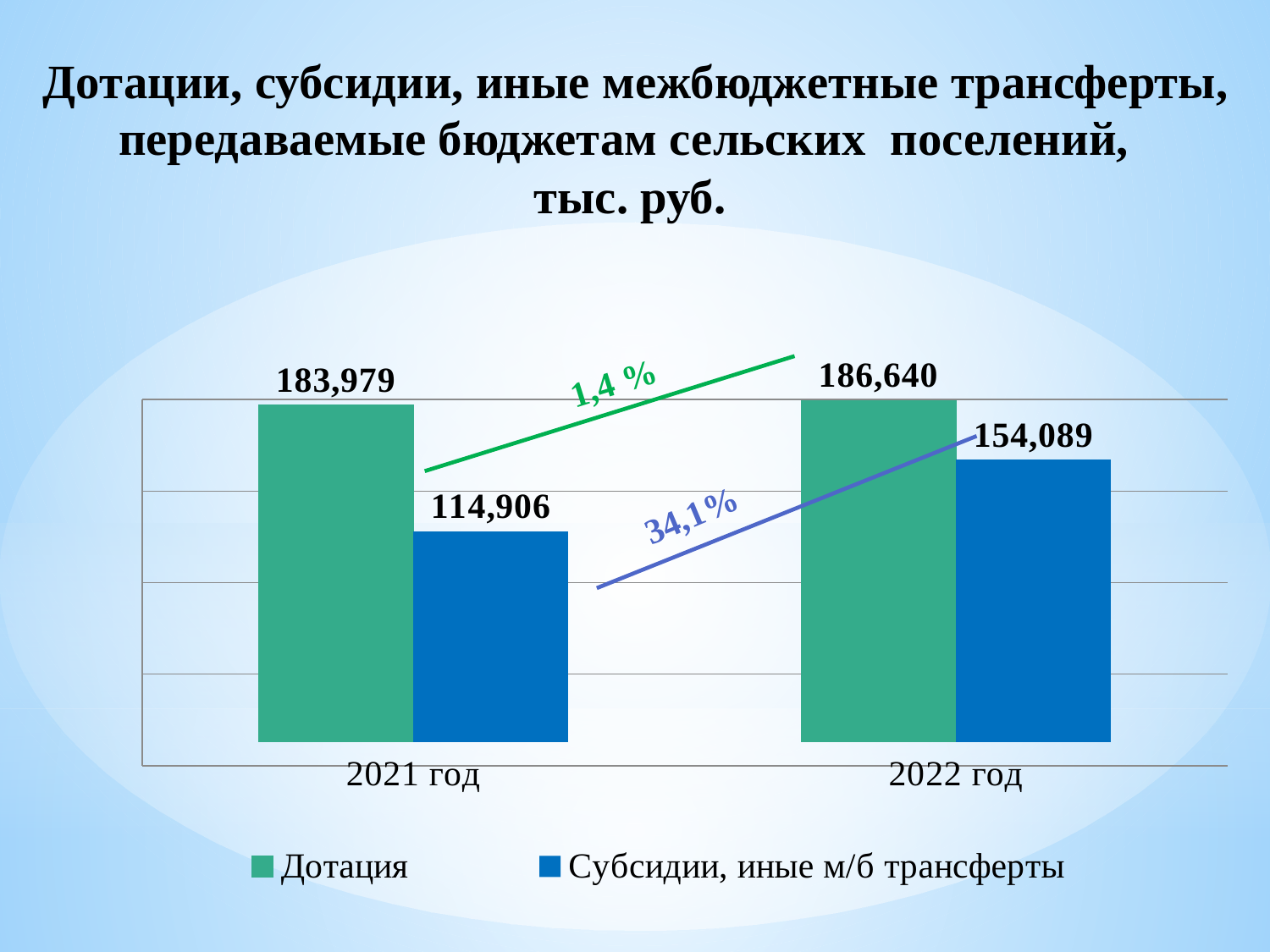
Which bar has the highest value on the chart? Дотация, 2022 год What kind of chart is shown on the slide? Bar chart What is the difference between the Дотация values for 2022 год and 2021 год? 2,661 What is the value of Дотация for 2022 год? 186,640 Which is larger in 2021 год: Дотация or Субсидии, иные м/б трансферты? Дотация What percentage growth is shown for Субсидии, иные м/б трансферты from 2021 год to 2022 год? 34,1% What is the difference between the Субсидии, иные м/б трансферты values for 2022 год and 2021 год? 39,183 What is the value of Дотация for 2021 год? 183,979 What is the value of Субсидии, иные м/б трансферты for 2021 год? 114,906 Which bar has the lowest value on the chart? Субсидии, иные м/б трансферты, 2021 год How many series does the legend list? 2 What is the value of Субсидии, иные м/б трансферты for 2022 год? 154,089